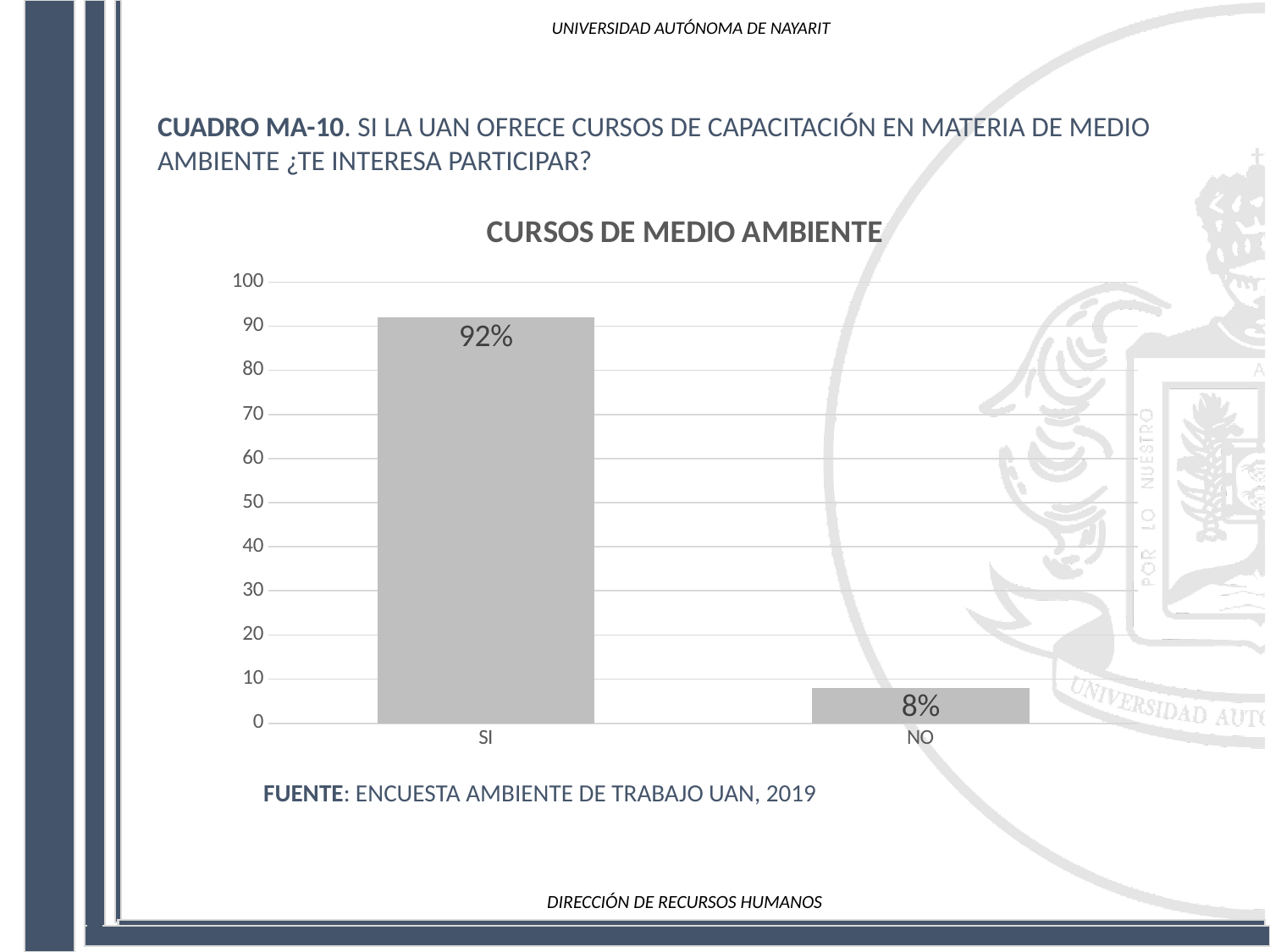
Is the value for NO greater or less than 10? less What is the maximum value shown on the y axis of the chart? 100 What is the value for NO in the CURSOS DE MEDIO AMBIENTE chart? 8% What is the title of the chart? CURSOS DE MEDIO AMBIENTE Which category has the lowest value in the chart? NO What kind of chart is shown on the slide? bar chart What is the value for SI in the CURSOS DE MEDIO AMBIENTE chart? 92% Which is larger, the value for SI or the value for NO? SI Is the value for SI greater or less than 50? greater What is the difference between the values for SI and NO? 84% How many categories are shown on the x axis of the chart? 2 Which category has the highest value in the chart? SI